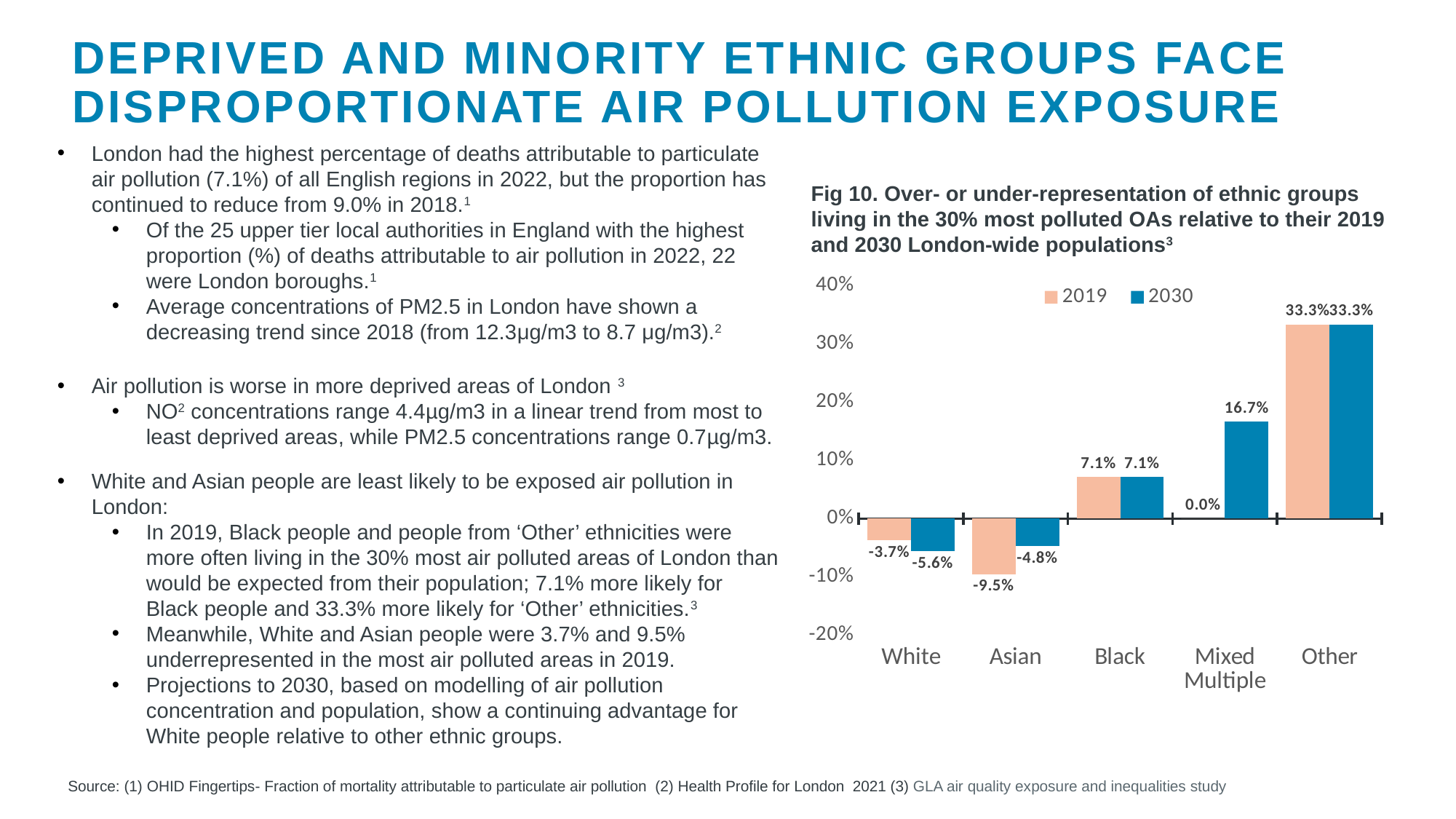
What is the difference between the 2019 values for Asian and White in Fig 10? 5.8% How many ethnic groups are shown on the x axis of Fig 10? 5 What is the difference between the 2030 and 2019 values for Mixed Multiple in Fig 10? 16.7% What is the 2019 value for Asian in Fig 10? -9.5% What kind of chart is Fig 10? Bar chart Which ethnic group has the highest 2019 value in Fig 10? Other What is the 2030 value for Mixed Multiple in Fig 10? 16.7% Which ethnic group has the lowest 2019 value in Fig 10? Asian In Fig 10, is the 2019 value for Asian or the 2030 value for Asian larger? 2030 What is the 2030 value for White in Fig 10? -5.6% Which ethnic group has the lowest 2030 value in Fig 10? White How many series does the legend of Fig 10 list? 2